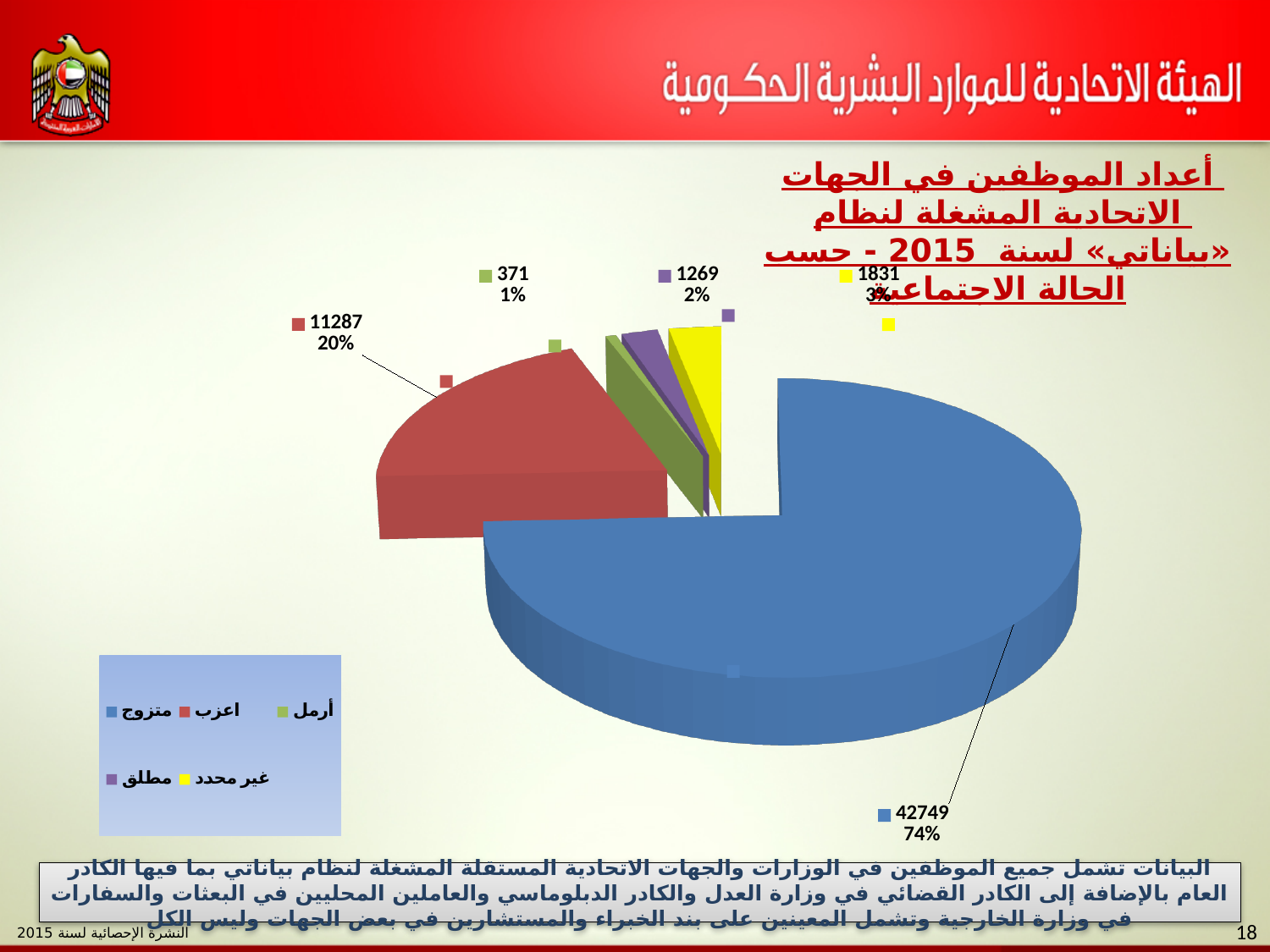
What type of chart is shown on the slide? pie chart What is the value shown for the مطلق (divorced) category? 1269 Which category has the smallest slice in the pie chart? أرمل How many slices does the pie chart have? 5 What is the value shown for the أرمل (widowed) category? 371 What is the number of employees in the متزوج (married) category? 42749 What percentage share does the غير محدد (unspecified) slice represent? 3% What percentage share does the اعزب (single) slice represent? 20% What is the difference between the متزوج value and the اعزب value? 31462 Which is larger, the مطلق value or the غير محدد value? غير محدد Which category has the largest slice in the pie chart? متزوج How many categories does the legend of the pie chart list? 5